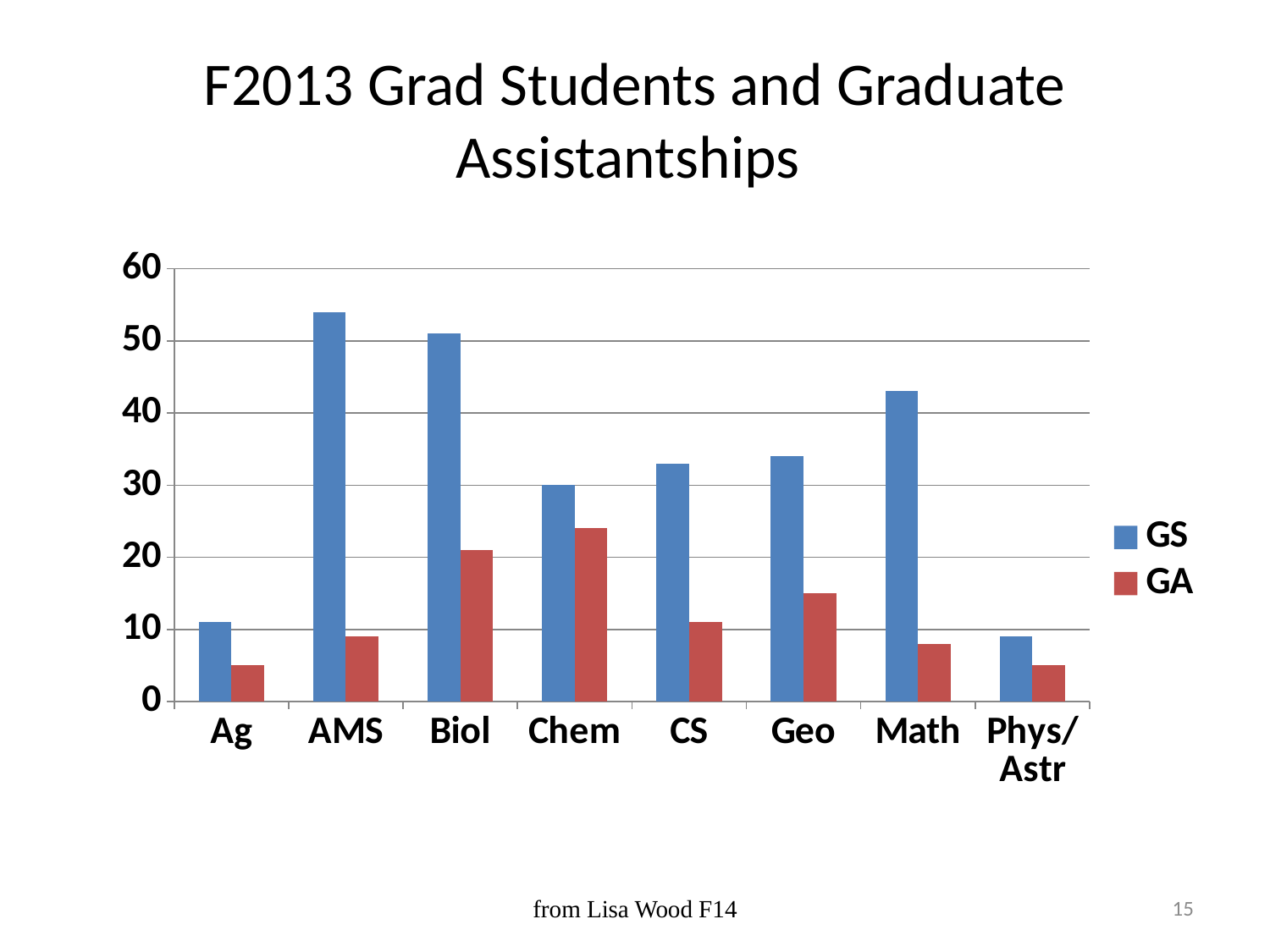
Is the GS value for AMS greater or less than 50? greater Which department has the lowest GS value? Phys/Astr How many departments (categories) are shown on the x axis? 8 What are the two series named in the legend? GS and GA Which department has the highest GS value? AMS Which department has the highest GA value? Chem Is the GS value for Math greater or less than 40? greater What kind of chart is shown on the slide? bar chart Is the GA value for Geo greater or less than 10? greater How many series does the legend list? 2 For Chem, which is larger, the GS value or the GA value? GS